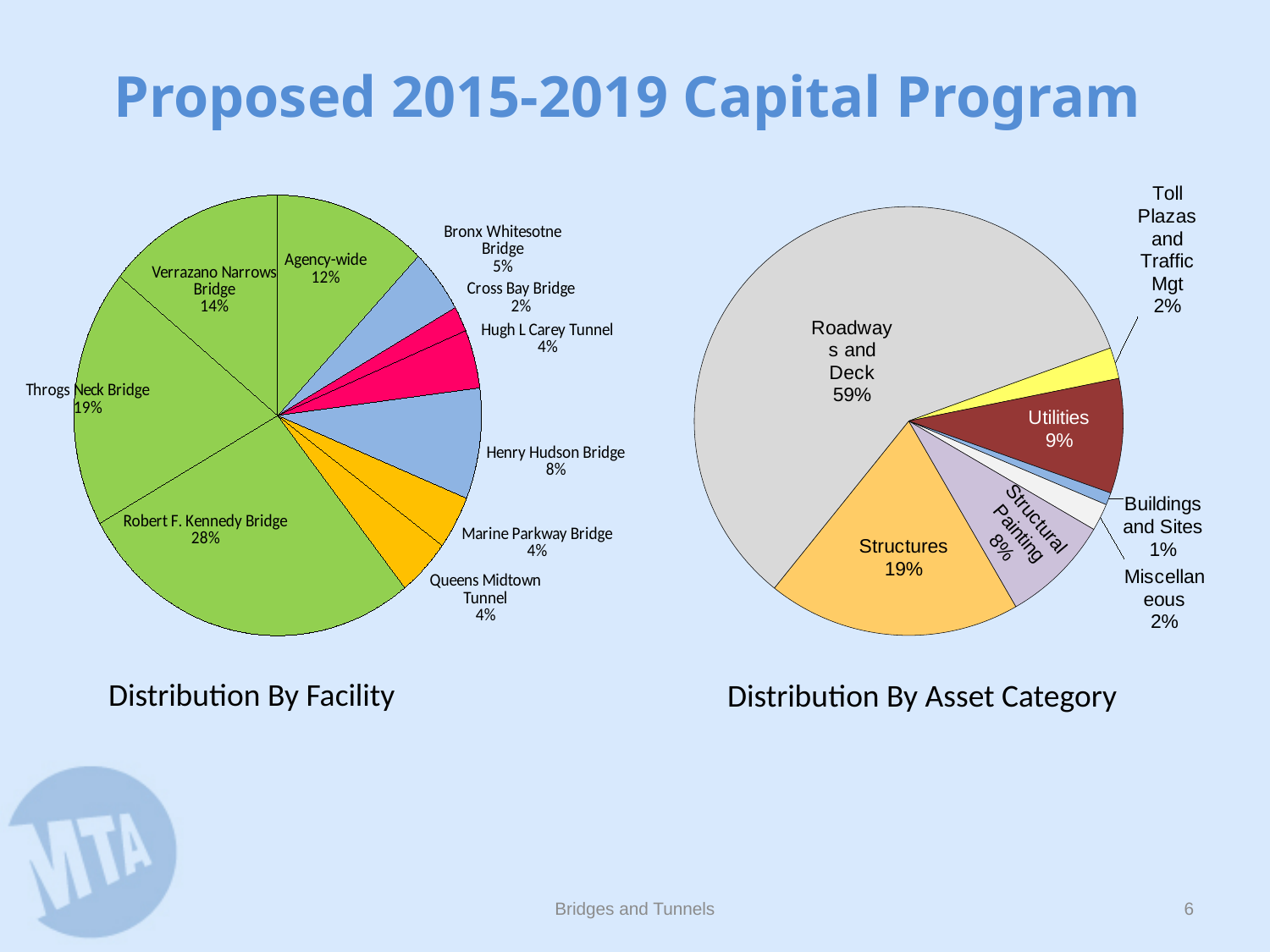
How many facilities are shown in the Distribution By Facility pie chart? 10 In the Distribution By Facility chart, what share does the Robert F. Kennedy Bridge have? 28% In the Distribution By Asset Category chart, which category has the smallest share? Buildings and Sites In the Distribution By Asset Category chart, what percentage is shown for Utilities? 9% In the Distribution By Facility chart, which facility has the largest share? Robert F. Kennedy Bridge In the Distribution By Facility chart, what percentage is shown for the Throgs Neck Bridge? 19% In the Distribution By Facility chart, which is larger, the Henry Hudson Bridge share or the Hugh L Carey Tunnel share? Henry Hudson Bridge In the Distribution By Facility chart, which facility has the smallest share? Cross Bay Bridge What type of chart is used for the Distribution By Asset Category? Pie chart In the Distribution By Asset Category chart, what is the difference between the Structures share and the Structural Painting share? 11% In the Distribution By Facility chart, what is the difference between the Verrazano Narrows Bridge share and the Agency-wide share? 2% In the Distribution By Asset Category chart, what share does Roadways and Deck have? 59%